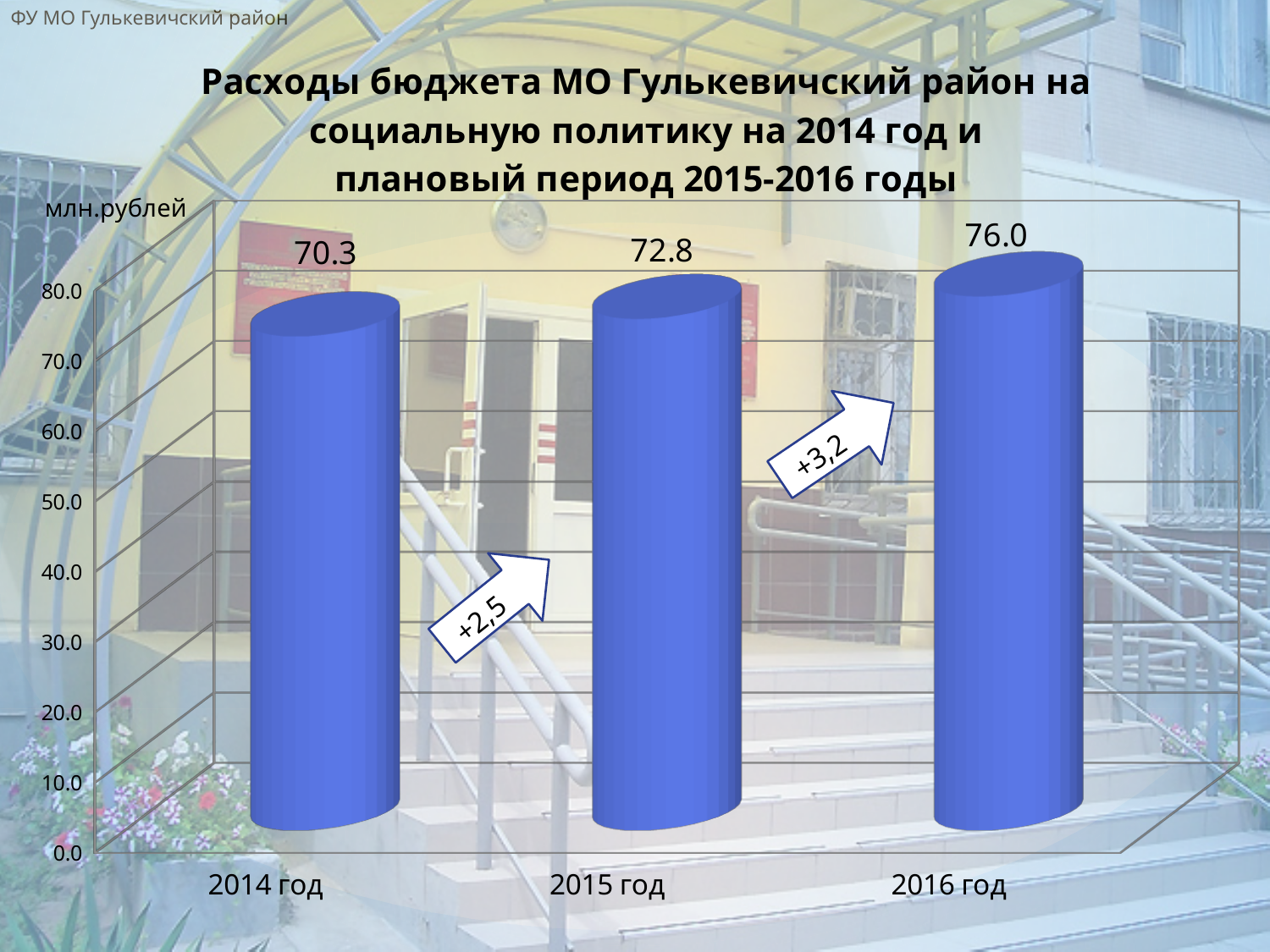
What is the value for 2015 год? 72.8 What unit is shown on the vertical axis label? млн.рублей What is the value for 2014 год? 70.3 Which year has the highest value? 2016 год What kind of chart is this? bar chart Do the values rise or fall from 2014 год to 2016 год? rise What is the difference between the values for 2016 год and 2014 год? 5.7 What is the difference between the values for 2015 год and 2014 год? 2.5 Which is larger, the value for 2015 год or the value for 2016 год? 2016 год What is the value for 2016 год? 76.0 Which year has the lowest value? 2014 год How many years are shown on the chart? 3